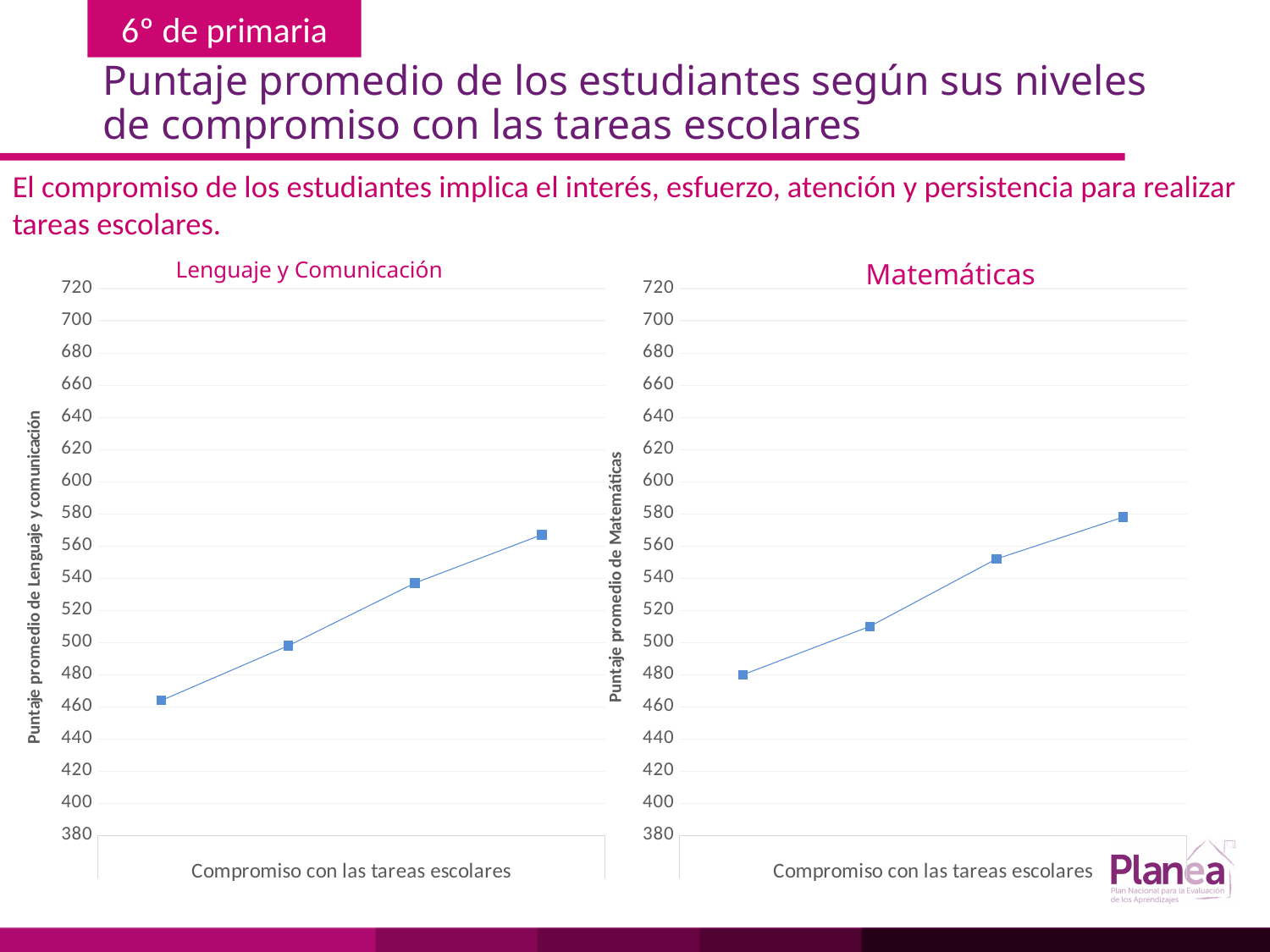
In the 'Lenguaje y Comunicación' chart, do the values rise or fall from left to right? rise In the 'Matemáticas' chart, do the values rise or fall from left to right? rise How many data points are plotted in the 'Lenguaje y Comunicación' chart? 4 What is the x-axis title of the 'Matemáticas' chart? Compromiso con las tareas escolares In the 'Lenguaje y Comunicación' chart, is the value of the rightmost point greater or less than 540? greater In the 'Matemáticas' chart, is the value of the second point from the left greater or less than 500? greater How many data points are plotted in the 'Matemáticas' chart? 4 What is the y-axis title of the 'Lenguaje y Comunicación' chart? Puntaje promedio de Lenguaje y comunicación In the 'Matemáticas' chart, is the value of the rightmost point greater or less than 560? greater What kind of chart is the 'Lenguaje y Comunicación' chart? line chart What kind of chart is the 'Matemáticas' chart? line chart